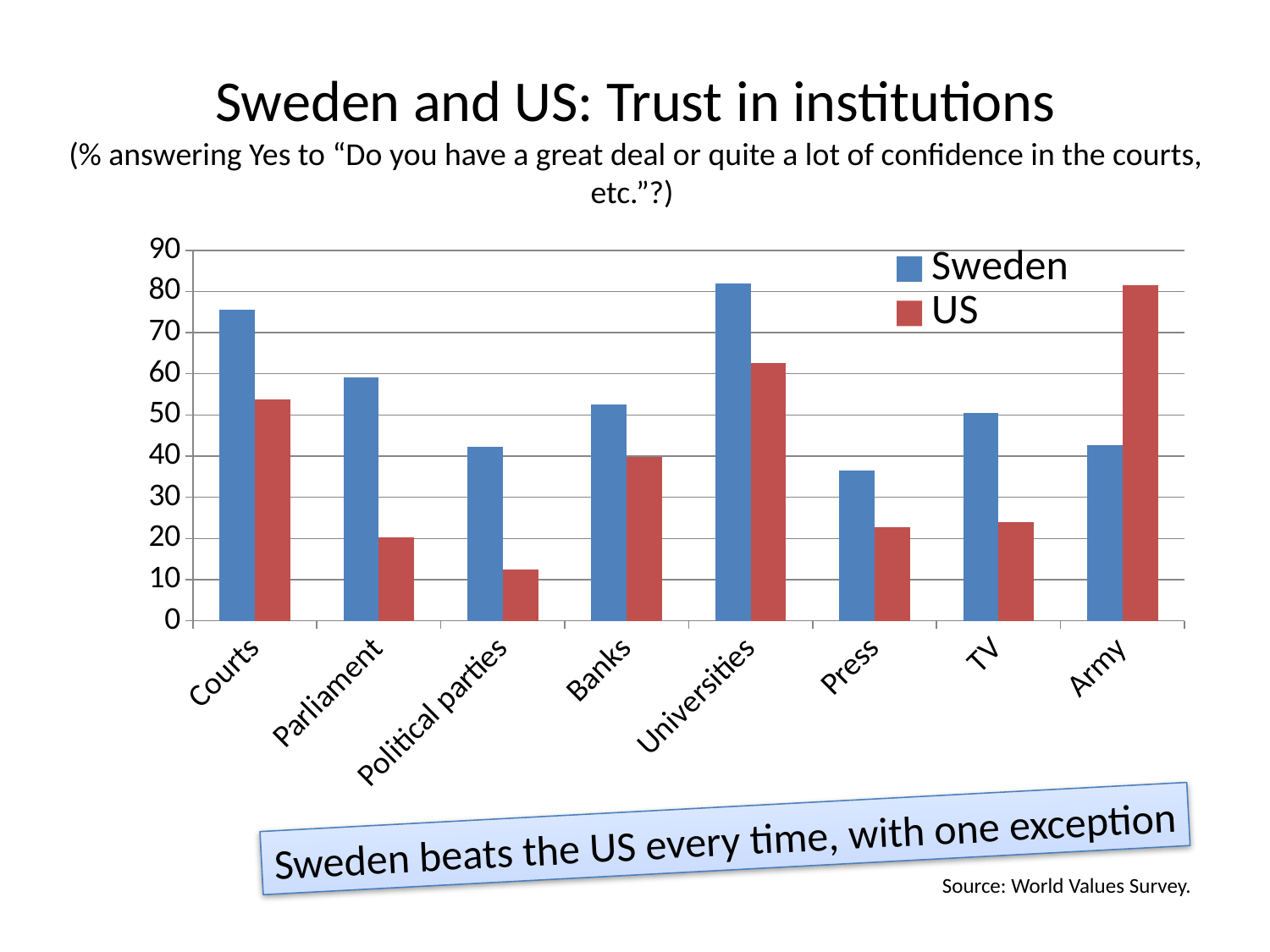
For which institution is the Sweden value lowest? Press Which colour represents the US series in the chart? red For Parliament, which is larger, the Sweden value or the US value? Sweden How many institutions (categories) are shown on the x axis? 8 How many series does the legend list? 2 What kind of chart is shown on the slide? bar chart For which institution is the US value lowest? Political parties Is the Sweden value for Courts greater or less than 70? greater Is the US value for Political parties greater or less than 20? less For which institution is the Sweden value highest? Universities For which institution is the US value highest? Army For Army, which is larger, the Sweden value or the US value? US